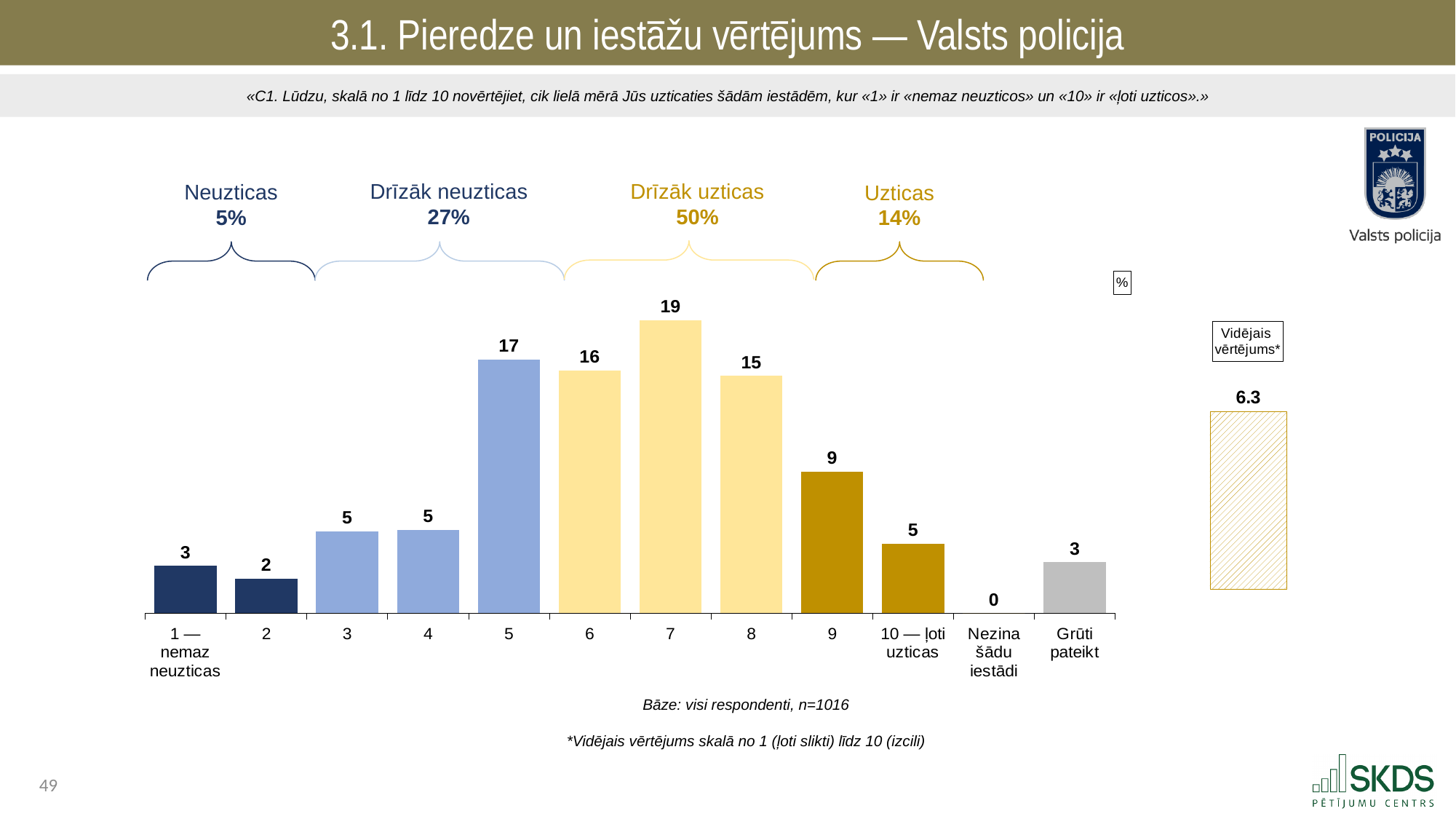
Which is larger, the value for rating 5 or the value for rating 6? rating 5 What is the value shown for the rating '1 — nemaz neuzticas'? 3 Which rating category has the highest value in the chart? 7 How many categories are shown on the x axis of the chart? 12 What share of respondents falls into the 'Drīzāk uzticas' group? 50% Which category has the lowest value in the chart? Nezina šādu iestādi What percentage of respondents gave a rating of 7? 19 What is the difference between the values for rating 7 and rating 8? 4 What type of chart is shown on the slide? bar chart What is the combined value of the bars for ratings 9 and '10 — ļoti uzticas'? 14 What is the value shown for 'Grūti pateikt'? 3 What is the average rating (Vidējais vērtējums) shown on the slide? 6.3